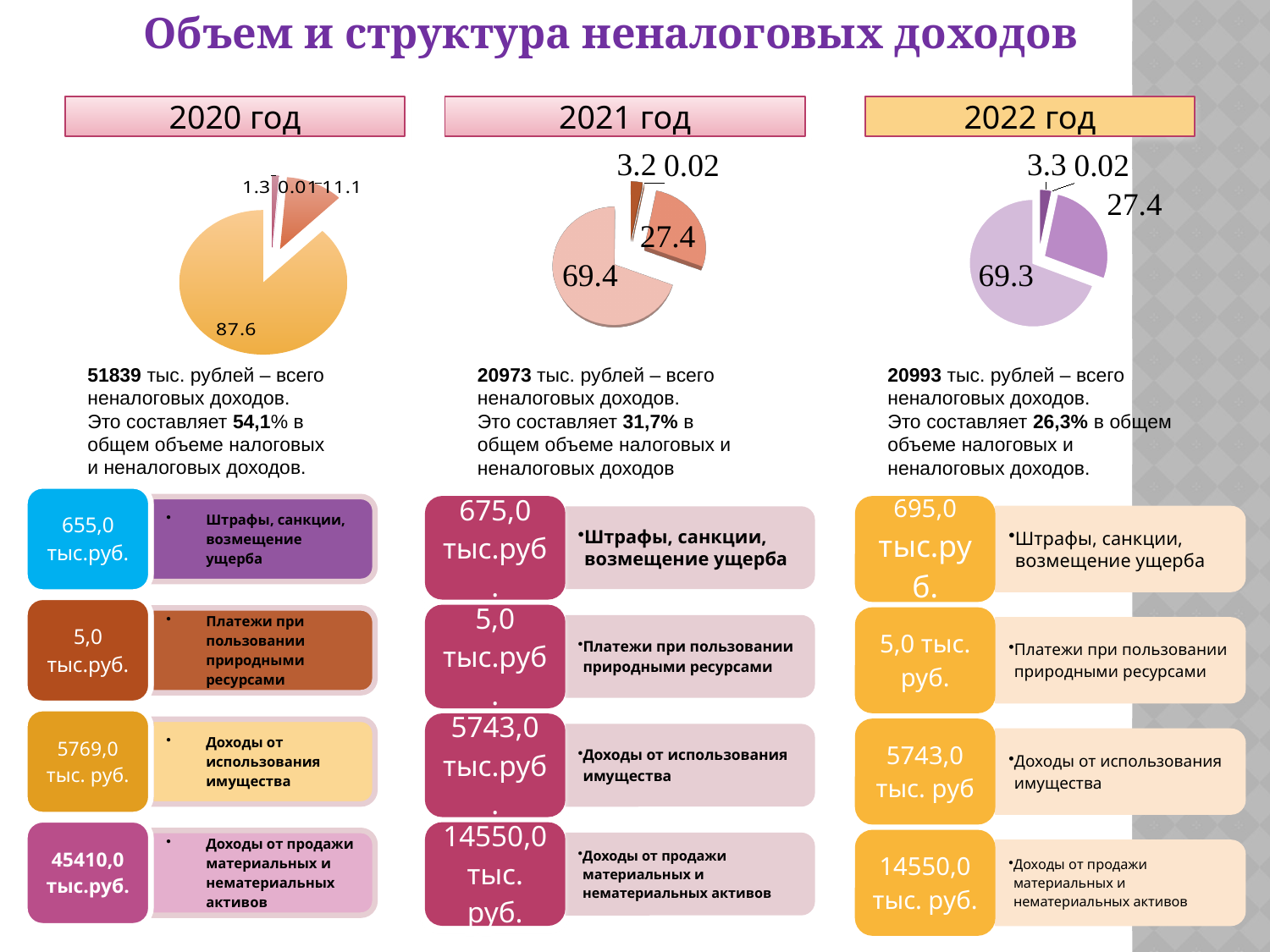
How many pie charts are on the slide? 3 Which is larger: the second-largest slice in the 2020 год pie chart or the second-largest slice in the 2021 год pie chart? 2021 год (27.4) What is the title of the slide containing the pie charts? Объем и структура неналоговых доходов In the 2021 год pie chart, what is the value of the smallest slice? 0.02 In the 2022 год pie chart, what is the value of the largest slice? 69.3 In the 2020 год pie chart, what is the value of the largest slice? 87.6 How many slices does the 2021 год pie chart have? 4 In the 2022 год pie chart, what is the value of the second-largest slice? 27.4 What is the difference between the largest slice in the 2020 год pie chart (87.6) and the largest slice in the 2021 год pie chart (69.4)? 18.2 In the 2021 год pie chart, what is the value of the largest slice? 69.4 In the 2020 год pie chart, what is the value of the smallest slice? 0.01 What type of chart is used for each year on the slide? Pie chart